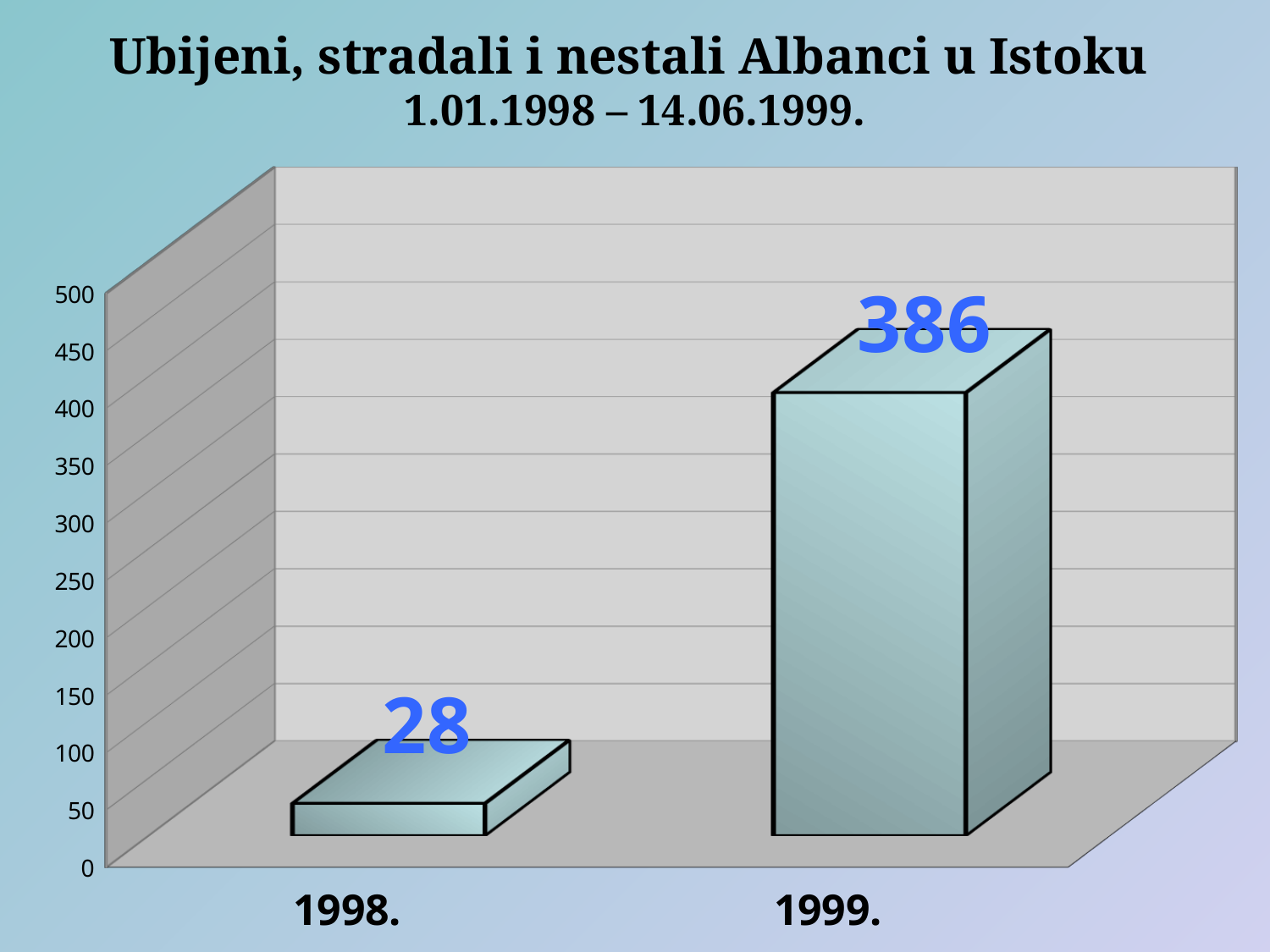
Which year has the lowest value? 1998. Is the value for 1998. greater or less than 100? less What is the value for 1999.? 386 What kind of chart is shown on the slide? bar chart How many categories are shown on the x axis? 2 Do the values rise or fall from 1998. to 1999.? rise Which is larger, the value for 1998. or the value for 1999.? 1999. Which year has the highest value? 1999. What is the title of the chart? Ubijeni, stradali i nestali Albanci u Istoku 1.01.1998 – 14.06.1999. Is the value for 1999. greater or less than 300? greater What is the value for 1998.? 28 What is the difference between the values for 1999. and 1998.? 358